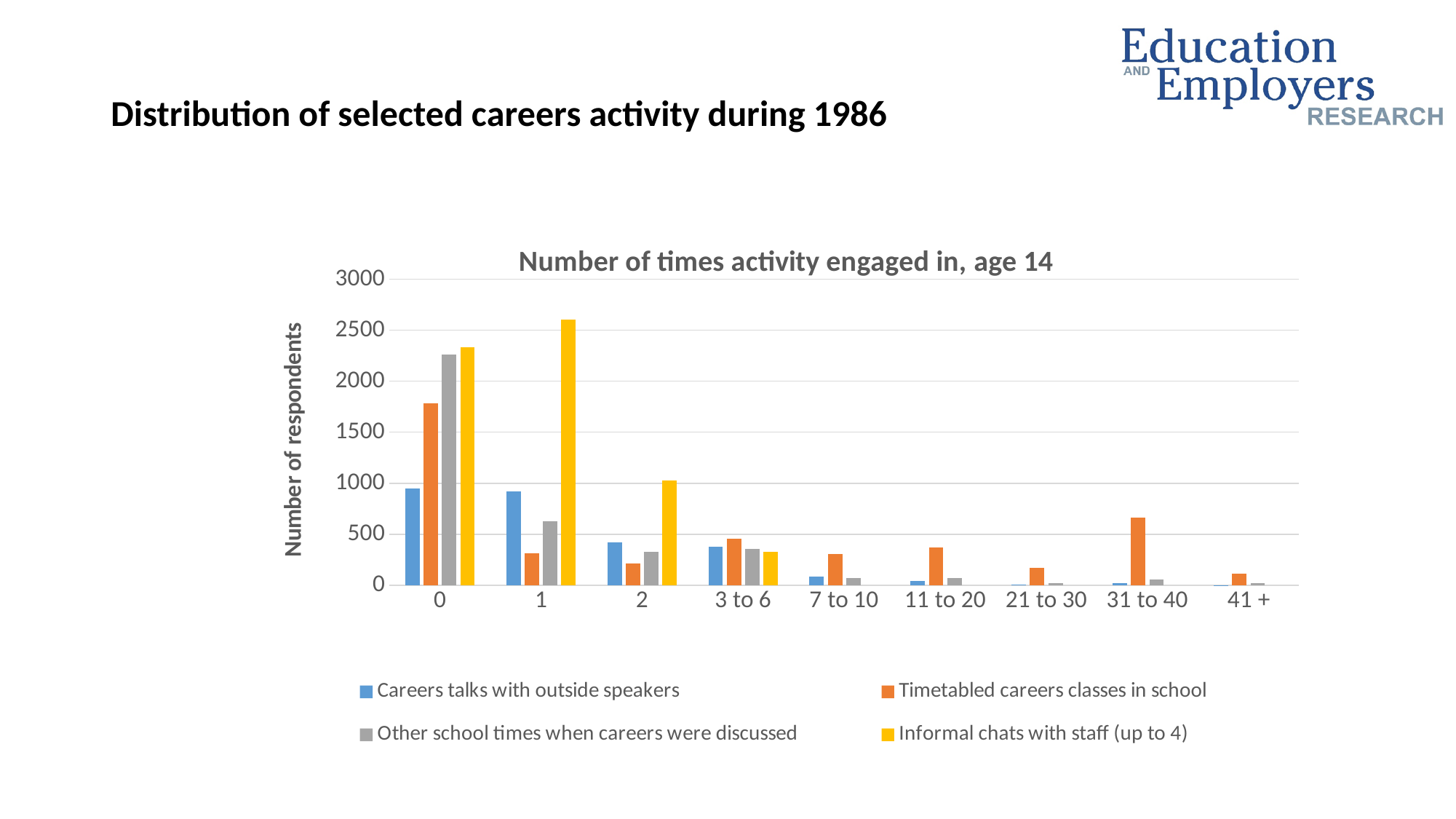
How many series does the legend list? 4 Is the value for Careers talks with outside speakers at category 0 greater or less than 1000? less What is the title of the chart? Number of times activity engaged in, age 14 Do the values for Careers talks with outside speakers generally rise or fall moving from category 0 to 41 +? fall How many categories are shown along the x axis? 9 For which category is the bar for Timetabled careers classes in school highest? 0 For which category is the bar for Informal chats with staff (up to 4) highest? 1 At category 1, which is larger: Careers talks with outside speakers or Other school times when careers were discussed? Careers talks with outside speakers Is the value for Informal chats with staff (up to 4) at category 1 greater or less than 2500? greater Is the value for Timetabled careers classes in school at category 0 greater or less than 2000? less At category 31 to 40, which is larger: Timetabled careers classes in school or Other school times when careers were discussed? Timetabled careers classes in school What kind of chart is shown on the slide? bar chart